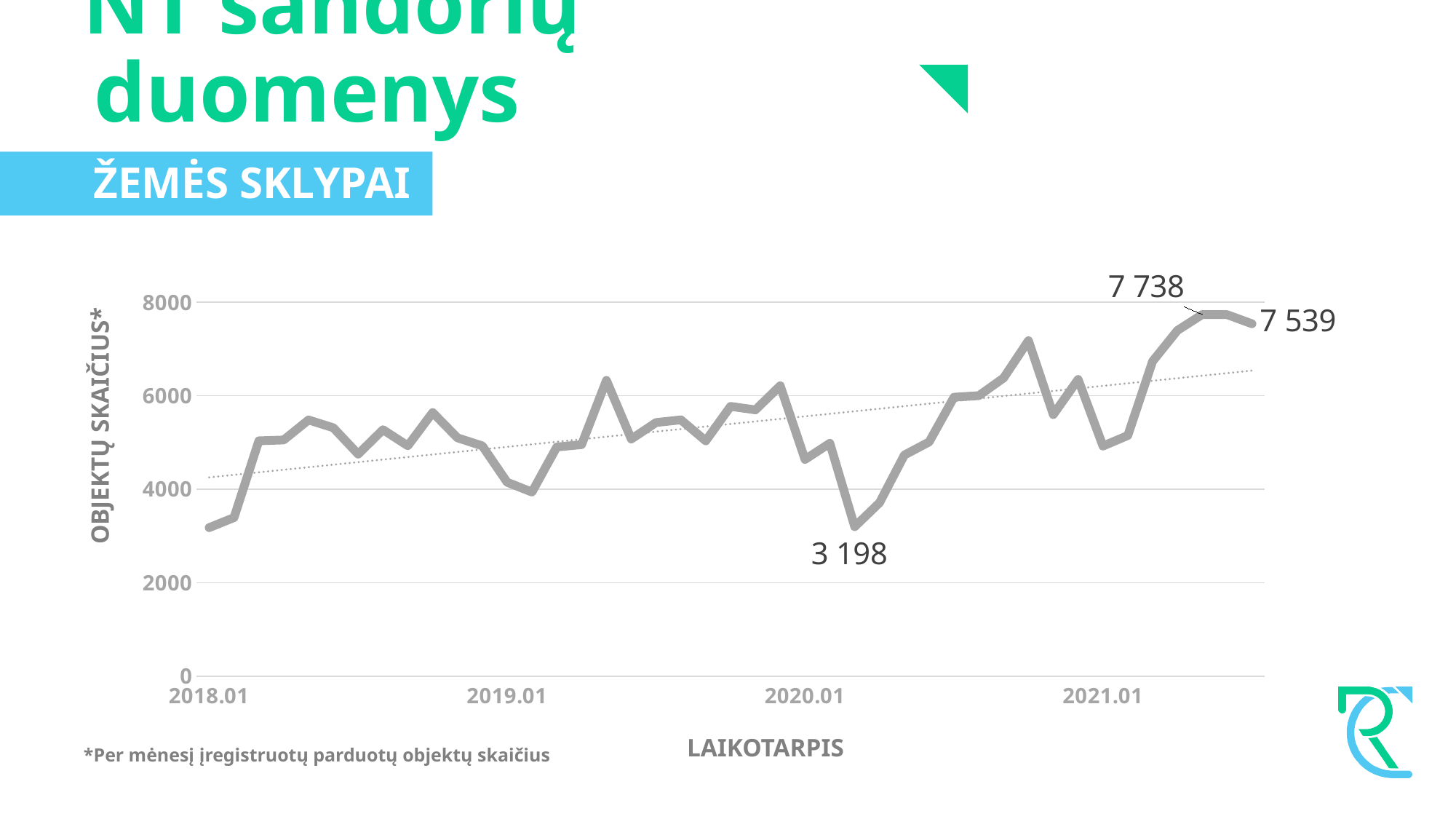
What kind of chart is shown on the slide? line chart What is the highest value labelled on the chart? 7 738 What is the lowest value labelled on the chart? 3 198 Does the overall trend of the line from 2018.01 to the end rise or fall? rise Which labelled value is larger, 7 539 or 3 198? 7 539 What is the difference between the labelled peak value 7 738 and the final value 7 539? 199 What is the difference between the labelled values 7 738 and 3 198? 4 540 Is the value at 2018.01 greater or less than 4000? less What is the title of the horizontal axis? LAIKOTARPIS What is the value labelled at the last point of the line? 7 539 Is the value at 2021.01 greater or less than 6000? less What is the title of the vertical axis? OBJEKTŲ SKAIČIUS*